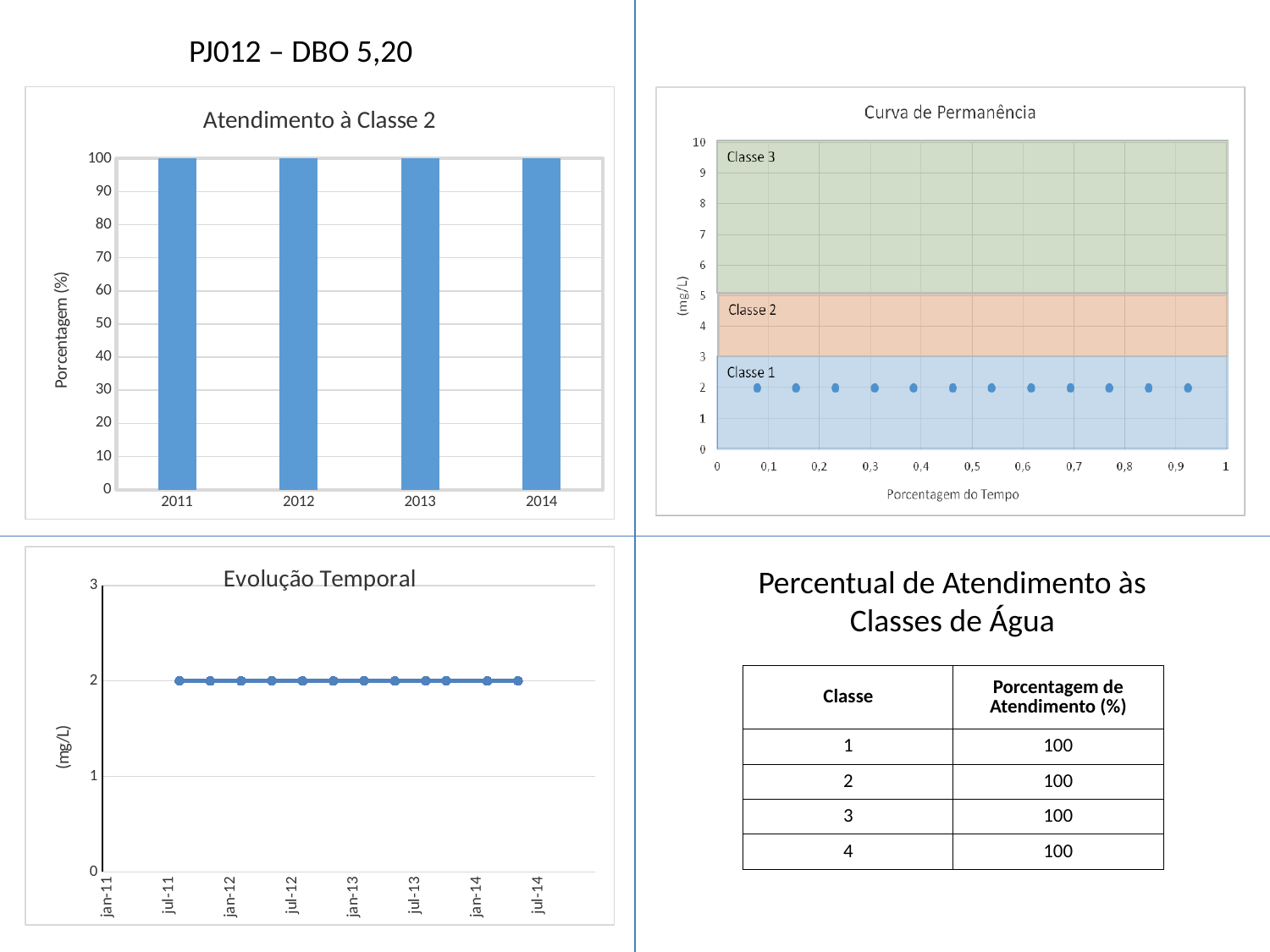
What is the y-axis label of the 'Atendimento à Classe 2' chart? Porcentagem (%) In the 'Atendimento à Classe 2' chart, is the value for 2012 greater or less than 50? greater In the 'Atendimento à Classe 2' chart, what is the difference between the values for 2013 and 2011? 0 In the 'Curva de Permanência' chart, which class band do all the plotted points fall in? Classe 1 How many data points are plotted in the 'Curva de Permanência' chart? 12 What kind of chart is 'Atendimento à Classe 2'? bar chart In the 'Evolução Temporal' chart, is the value at jan-13 greater or less than 1? greater In the 'Atendimento à Classe 2' chart, what is the value for 2011? 100 How many years are shown on the x axis of the 'Atendimento à Classe 2' chart? 4 In the 'Atendimento à Classe 2' chart, what is the value for 2014? 100 In the 'Evolução Temporal' chart, do the values rise, fall or stay flat over time? stay flat